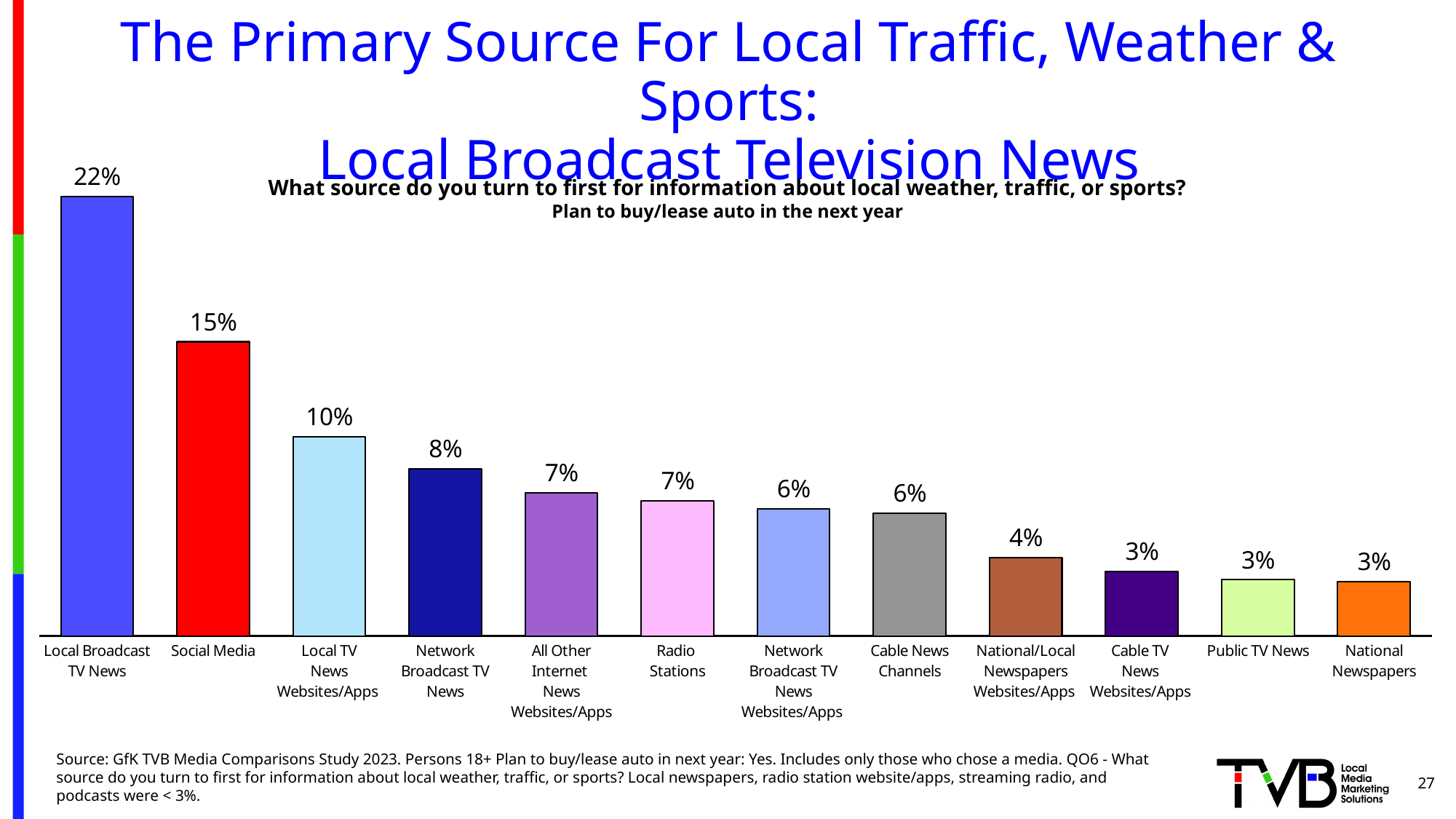
What kind of chart is shown on the slide? Bar chart What is the value shown for National/Local Newspapers Websites/Apps? 4% What is the value shown for Cable News Channels? 6% Which is larger, the value for Radio Stations or the value for Cable TV News Websites/Apps? Radio Stations What is the difference between the values for Local Broadcast TV News and Social Media? 7% What is the value shown for Social Media? 15% Do the values rise or fall moving from left to right across the chart? Fall What percentage of respondents turn first to Local Broadcast TV News for local weather, traffic, or sports? 22% What is the difference between the values for Local TV News Websites/Apps and Network Broadcast TV News? 2% How many sources share the lowest value of 3%? 3 Which source has the highest value on the chart? Local Broadcast TV News How many sources (bars) are shown on the chart? 12